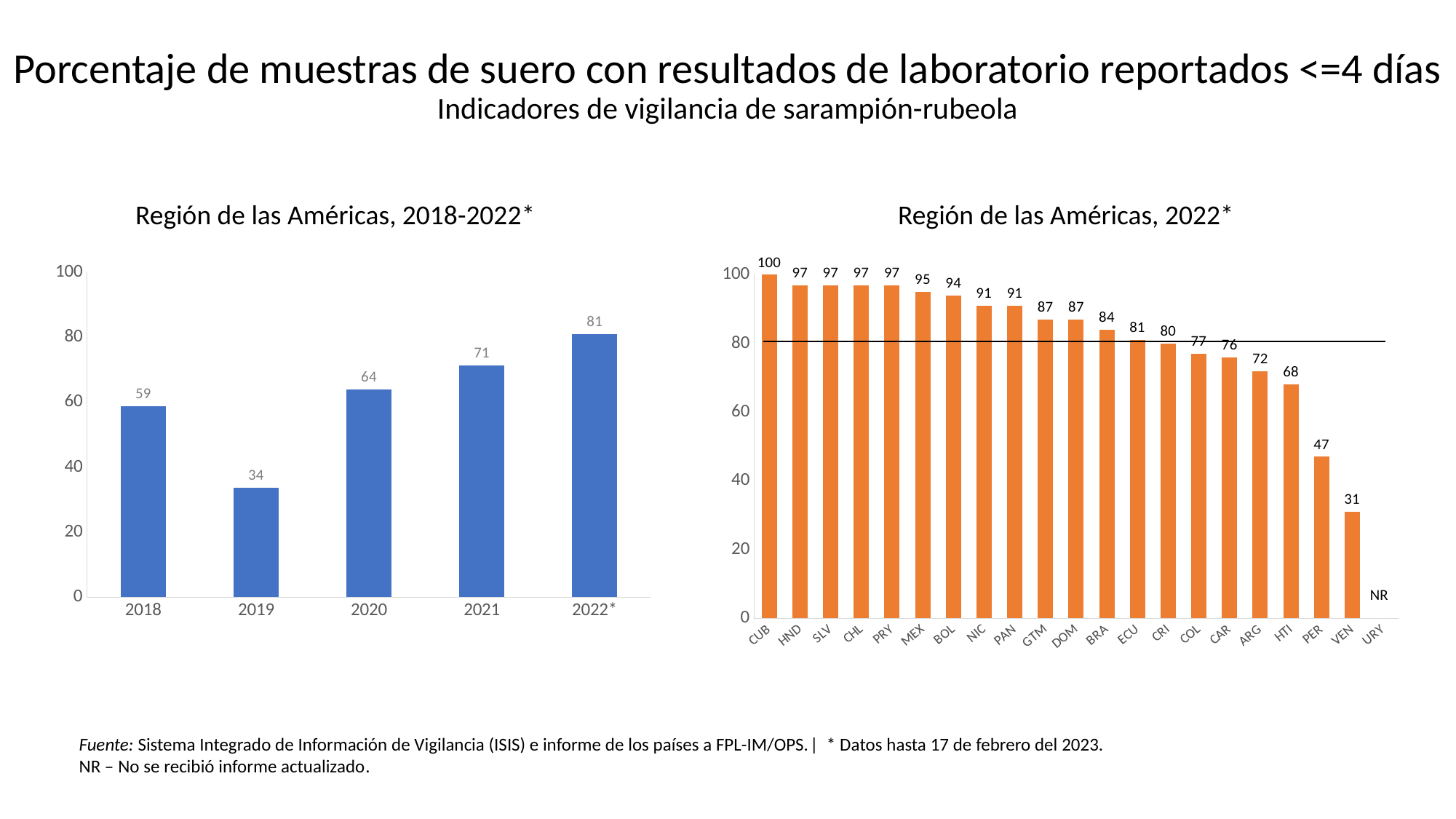
In the chart titled 'Región de las Américas, 2022*', what is the value for MEX? 95 In the chart titled 'Región de las Américas, 2022*', which country has the lowest plotted value? VEN In the chart titled 'Región de las Américas, 2018-2022*', which year has the lowest value? 2019 What type of chart is the chart titled 'Región de las Américas, 2022*'? bar chart In the chart titled 'Región de las Américas, 2022*', what is the difference between the values for GTM and ARG? 15 In the chart titled 'Región de las Américas, 2018-2022*', which year has the highest value? 2022* In the chart titled 'Región de las Américas, 2022*', which country has the highest value? CUB In the chart titled 'Región de las Américas, 2018-2022*', do the values rise or fall from 2019 to 2022*? rise In the chart titled 'Región de las Américas, 2018-2022*', what is the difference between the values for 2022* and 2021? 10 In the chart titled 'Región de las Américas, 2018-2022*', how many years are shown on the x axis? 5 In the chart titled 'Región de las Américas, 2018-2022*', what is the value for 2019? 34 In the chart titled 'Región de las Américas, 2022*', which is larger, the value for HTI or the value for PER? HTI